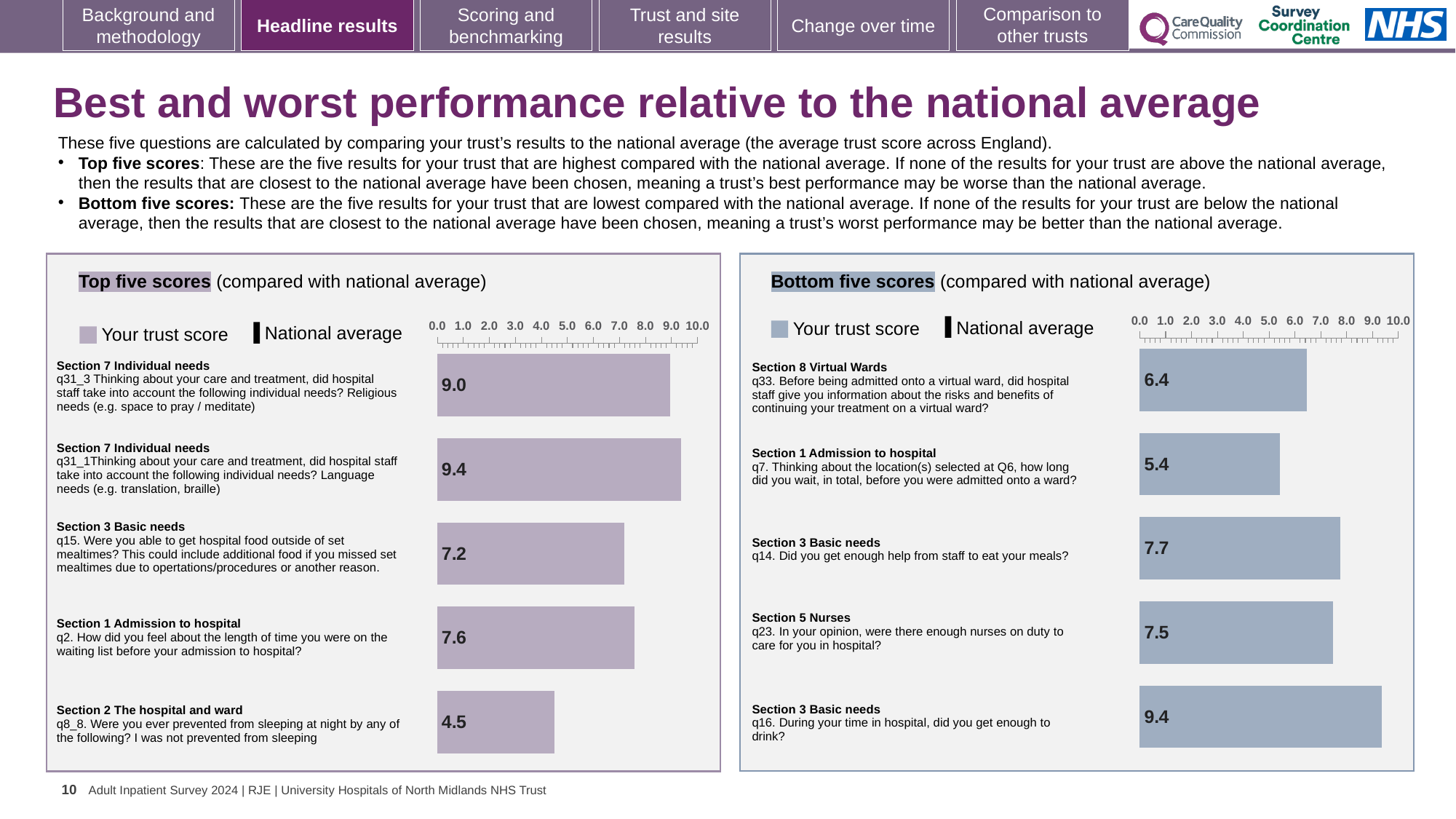
In the Bottom five scores chart, which question has the lowest trust score? q7 (wait before being admitted onto a ward) What type of chart is the Top five scores chart? Bar chart In the Bottom five scores chart, what is the trust score for q23 (enough nurses on duty)? 7.5 In the Bottom five scores chart, what is the trust score for q7 (how long did you wait before being admitted onto a ward)? 5.4 In the Top five scores chart, what is the trust score for q31_1 (language needs)? 9.4 In the Top five scores chart, what is the trust score for q8_8 (I was not prevented from sleeping)? 4.5 In the Top five scores chart, what is the difference between the trust scores for q31_1 and q8_8? 4.9 In the Top five scores chart, which has the larger trust score: q15 (food outside set mealtimes) or q2 (length of time on the waiting list)? q2 How many bars are shown in the Bottom five scores chart? 5 In the Bottom five scores chart, what is the difference between the trust scores for q16 and q33? 3.0 What two entries does the legend of the Bottom five scores chart list? Your trust score and National average In the Top five scores chart, which question has the highest trust score? q31_1 (Language needs)